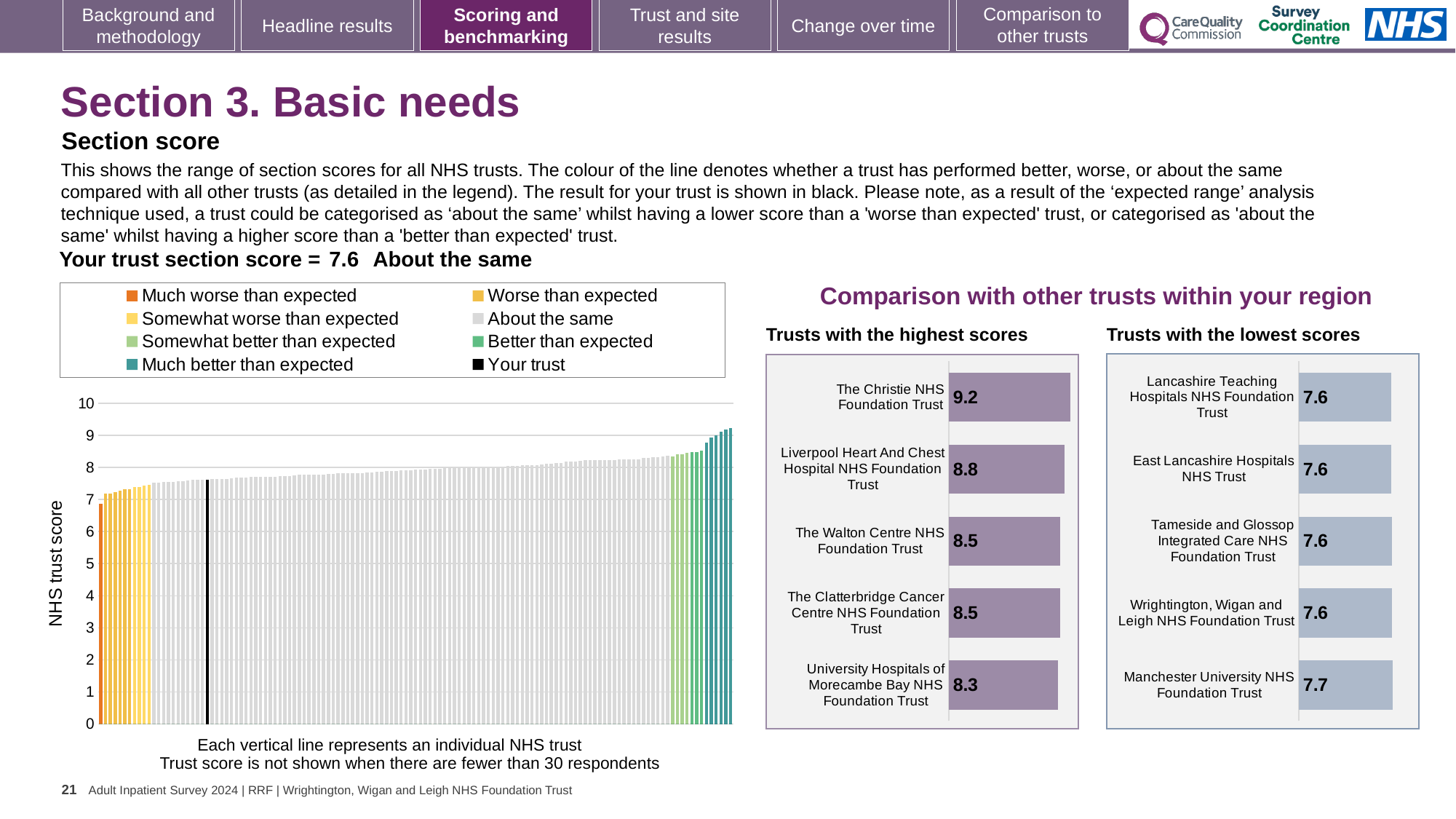
In the 'Trusts with the lowest scores' chart, which has the larger score: Manchester University NHS Foundation Trust or Wrightington, Wigan and Leigh NHS Foundation Trust? Manchester University NHS Foundation Trust In the 'Trusts with the highest scores' chart, what is the score for The Christie NHS Foundation Trust? 9.2 In the 'Trusts with the highest scores' chart, what is the score for University Hospitals of Morecambe Bay NHS Foundation Trust? 8.3 In the 'Trusts with the highest scores' chart, which trust has the highest score? The Christie NHS Foundation Trust What kind of chart is the large chart on the left showing NHS trust scores? Bar chart How many trusts are shown in the 'Trusts with the lowest scores' chart? 5 In the 'Trusts with the highest scores' chart, what is the difference between the scores of The Christie NHS Foundation Trust and Liverpool Heart And Chest Hospital NHS Foundation Trust? 0.4 In the large 'NHS trust score' chart, is the value of the black bar (your trust) greater or less than 7? greater How many entries does the legend of the large 'NHS trust score' chart list? 8 In the 'Trusts with the highest scores' chart, which trust has the lowest score? University Hospitals of Morecambe Bay NHS Foundation Trust In the large 'NHS trust score' chart, do the values rise or fall from left to right? Rise In the 'Trusts with the lowest scores' chart, what is the score for Manchester University NHS Foundation Trust? 7.7